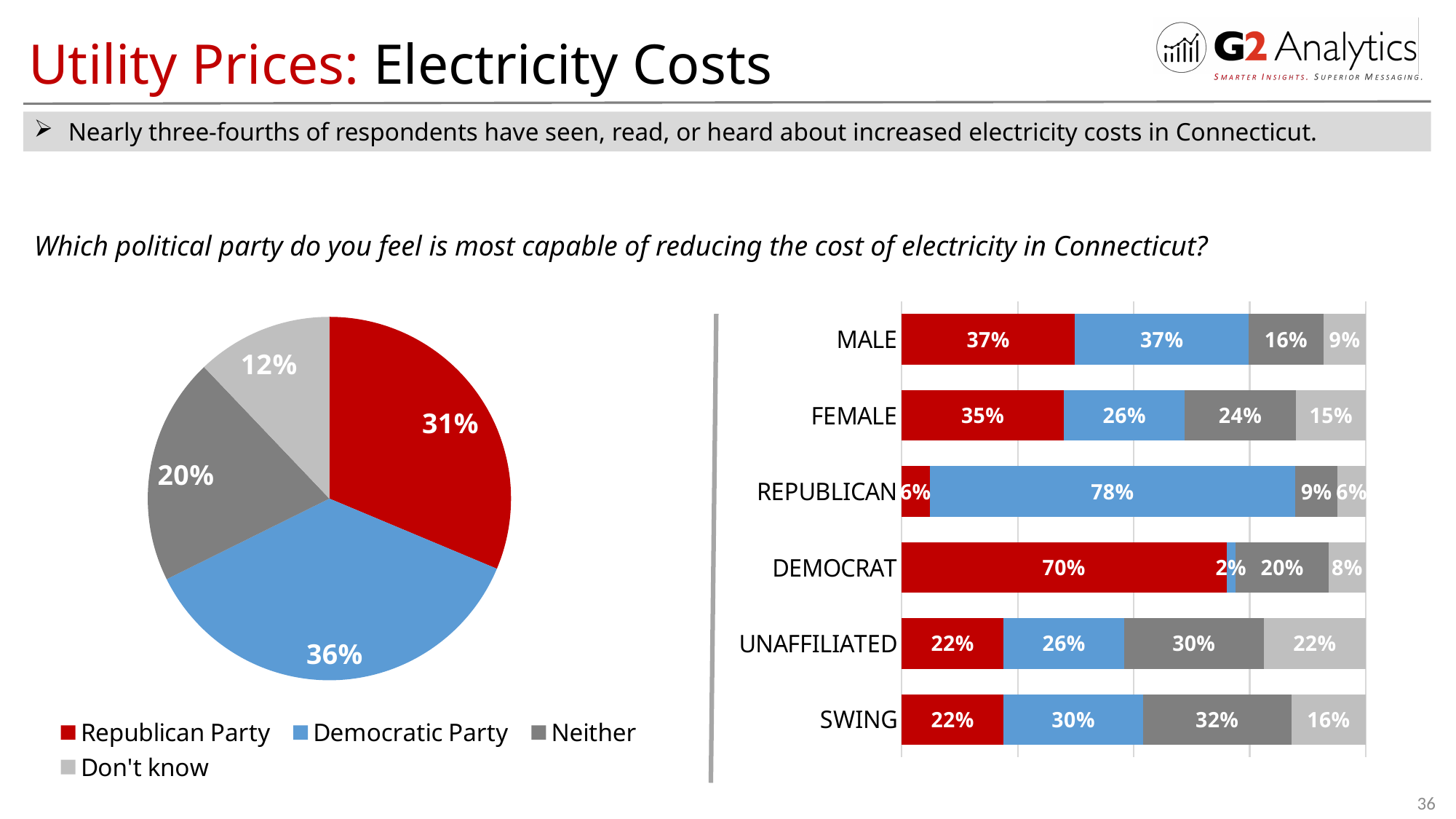
In the bar chart on the right, what is the value of the blue (Democratic Party) segment for REPUBLICAN? 78% In the pie chart on the left, which response has the largest slice? Democratic Party How many entries does the legend below the pie chart list? 4 In the pie chart on the left, what is the difference between the Democratic Party share and the Republican Party share? 5% In the bar chart on the right, what is the value of the red (Republican Party) segment for DEMOCRAT? 70% How many categories are shown on the bar chart on the right? 6 In the bar chart on the right, which category has the largest light grey (Don't know) segment? UNAFFILIATED In the pie chart on the left, which response has the smallest slice? Don't know In the bar chart on the right, is the red (Republican Party) segment larger for MALE or for SWING? MALE In the pie chart on the left, what share of respondents chose the Democratic Party? 36% In the bar chart on the right, what is the value of the dark grey (Neither) segment for FEMALE? 24% What kind of chart is shown on the right side of the slide? Stacked bar chart